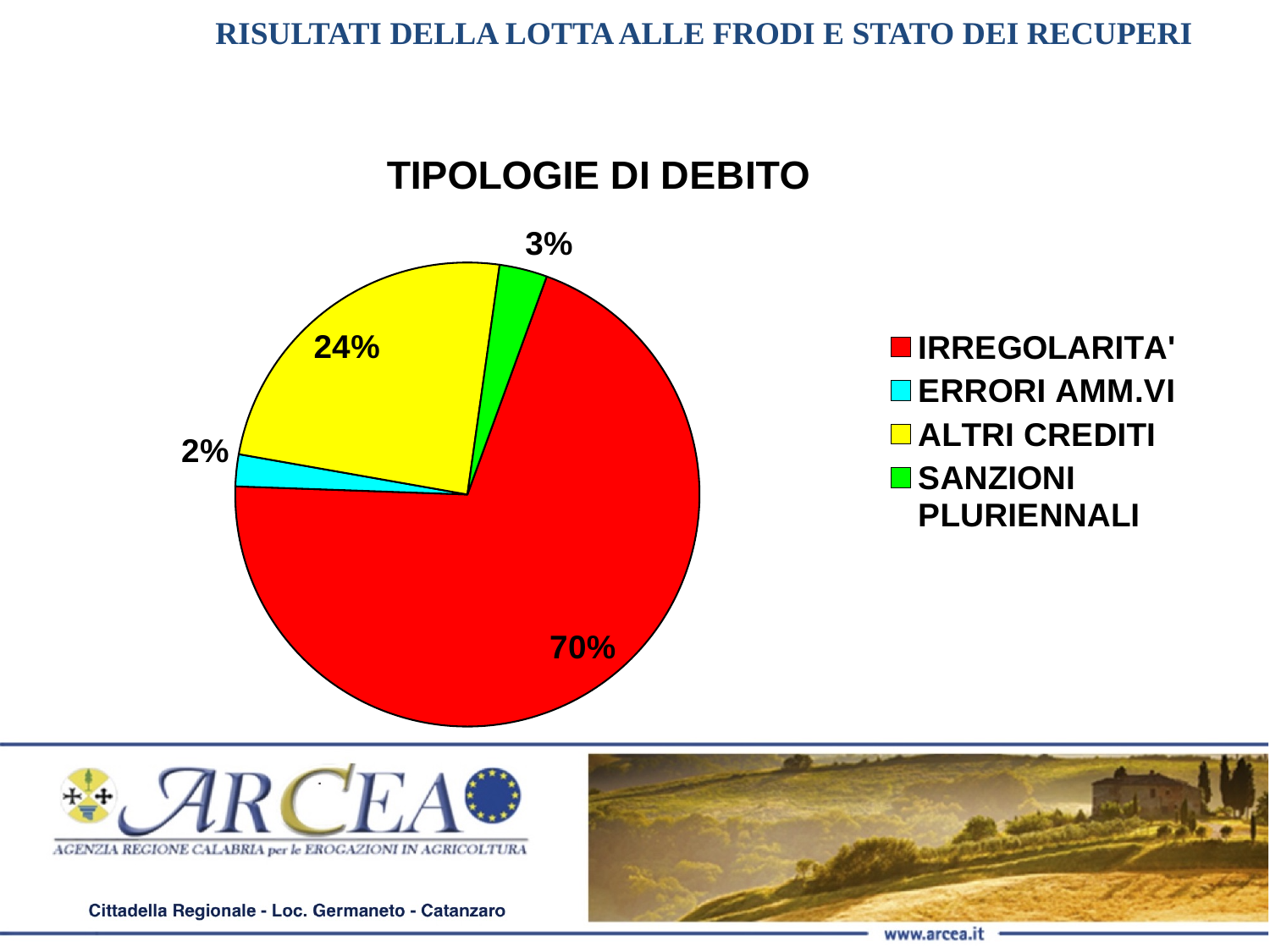
Which is larger, the share for SANZIONI PLURIENNALI or the share for ERRORI AMM.VI? SANZIONI PLURIENNALI What share of the pie does ALTRI CREDITI represent? 24% What share of the pie does SANZIONI PLURIENNALI represent? 3% What share of the pie does IRREGOLARITA' represent? 70% Which category has the largest slice of the pie? IRREGOLARITA' What colour is the slice for ALTRI CREDITI? yellow What is the title of the chart? TIPOLOGIE DI DEBITO What is the difference between the shares of IRREGOLARITA' and ALTRI CREDITI? 46% How many categories does the legend list? 4 What type of chart is shown on the slide? pie chart Which category has the smallest slice of the pie? ERRORI AMM.VI